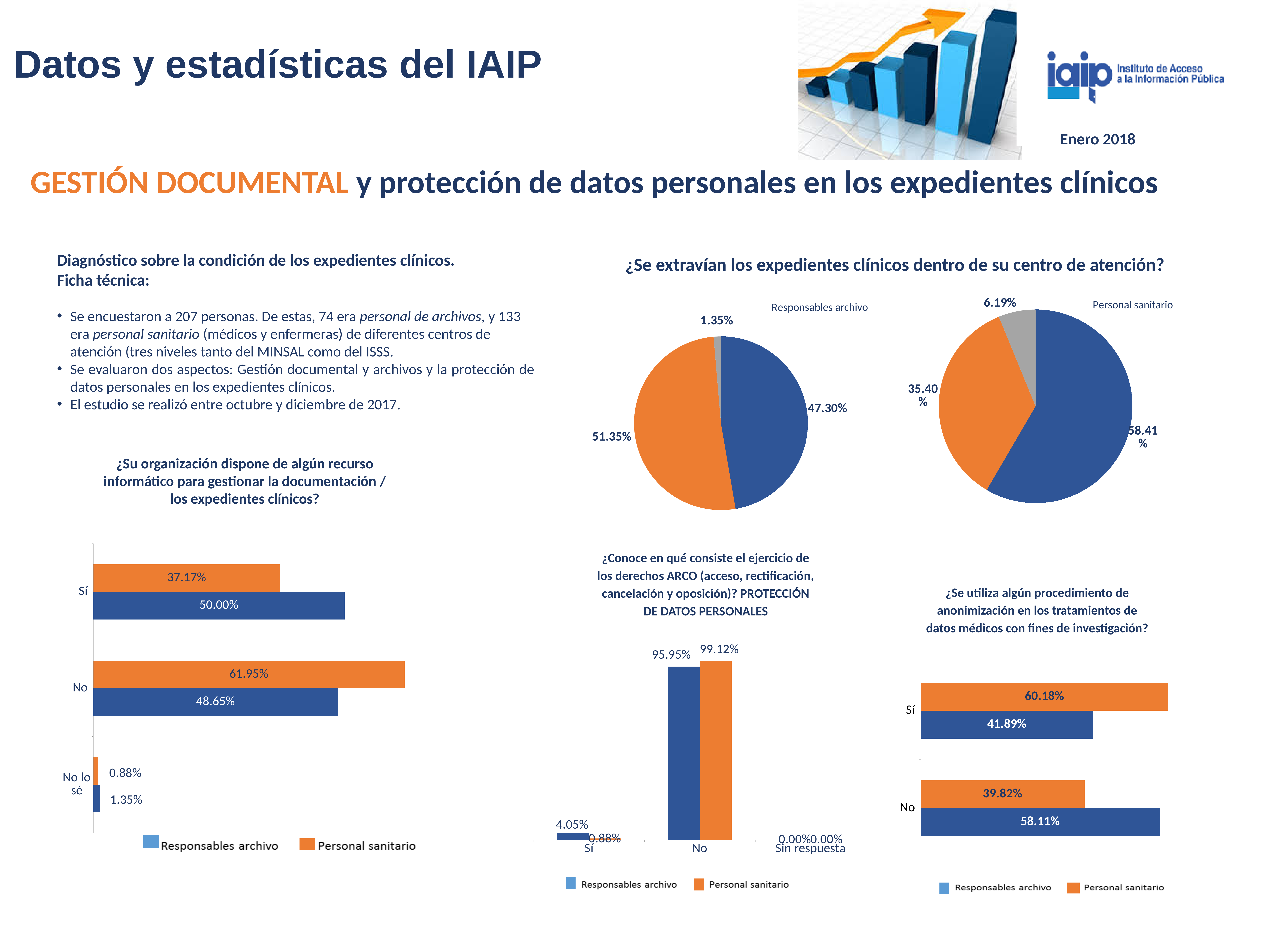
In the chart '¿Se utiliza algún procedimiento de anonimización en los tratamientos de datos médicos con fines de investigación?', which series has the larger value for 'Sí'? Personal sanitario In the 'Personal sanitario' pie chart under '¿Se extravían los expedientes clínicos dentro de su centro de atención?', what is the value of the largest slice? 58.41% In the chart '¿Conoce en qué consiste el ejercicio de los derechos ARCO...? PROTECCIÓN DE DATOS PERSONALES', what is the value for Responsables archivo in the 'Sí' category? 4.05% In the chart '¿Se utiliza algún procedimiento de anonimización en los tratamientos de datos médicos con fines de investigación?', how many series does the legend list? 2 In the chart '¿Su organización dispone de algún recurso informático para gestionar la documentación / los expedientes clínicos?', how many categories are shown on the axis? 3 In the chart '¿Su organización dispone de algún recurso informático para gestionar la documentación / los expedientes clínicos?', what is the value for Responsables archivo in the 'Sí' category? 50.00% In the chart '¿Se utiliza algún procedimiento de anonimización en los tratamientos de datos médicos con fines de investigación?', what is the value for Responsables archivo in the 'No' category? 58.11% In the chart '¿Su organización dispone de algún recurso informático para gestionar la documentación / los expedientes clínicos?', what is the difference between the Personal sanitario and Responsables archivo values for 'No'? 13.30% In the chart '¿Conoce en qué consiste el ejercicio de los derechos ARCO...? PROTECCIÓN DE DATOS PERSONALES', what is the value for Personal sanitario in the 'No' category? 99.12% In the chart '¿Conoce en qué consiste el ejercicio de los derechos ARCO...? PROTECCIÓN DE DATOS PERSONALES', which category has the highest values for both series? No In the 'Responsables archivo' pie chart under '¿Se extravían los expedientes clínicos dentro de su centro de atención?', what is the value of the smallest slice? 1.35% In the chart '¿Su organización dispone de algún recurso informático para gestionar la documentación / los expedientes clínicos?', what is the value for Personal sanitario in the 'No' category? 61.95%